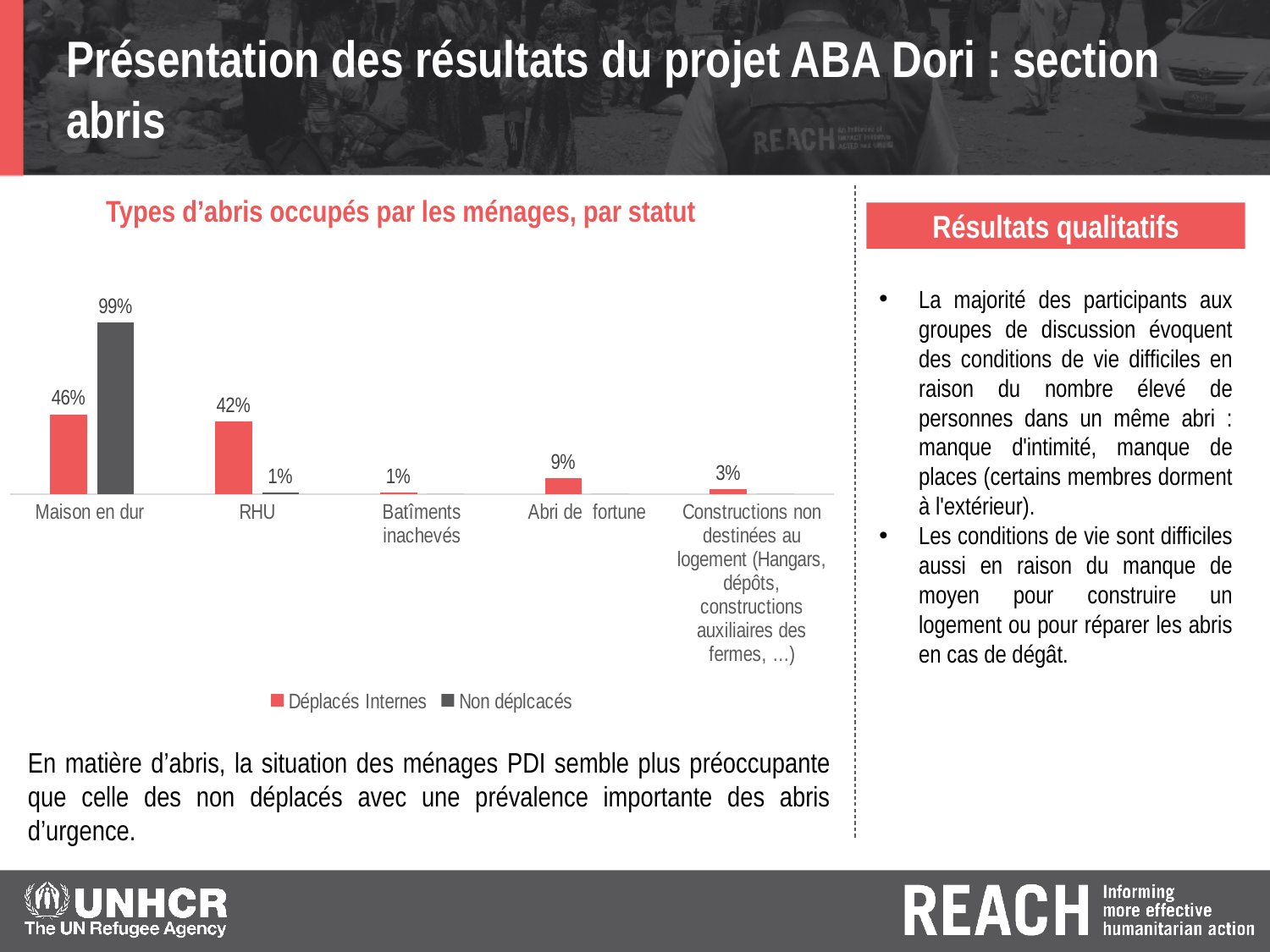
How many series does the legend list? 2 What is the value for Non déplacés in the Maison en dur category? 99% What is the value for Déplacés Internes in the Constructions non destinées au logement category? 3% What is the value for Déplacés Internes in the RHU category? 42% In the RHU category, which series has the larger value, Déplacés Internes or Non déplacés? Déplacés Internes What is the value for Déplacés Internes in the Maison en dur category? 46% How many shelter type categories are shown on the x axis? 5 What kind of chart is shown on the slide? Bar chart What is the value for Déplacés Internes in the Abri de fortune category? 9% What is the value for Non déplacés in the RHU category? 1% What is the difference between the Non déplacés and Déplacés Internes values for Maison en dur? 53% Which category has the highest value for Déplacés Internes? Maison en dur